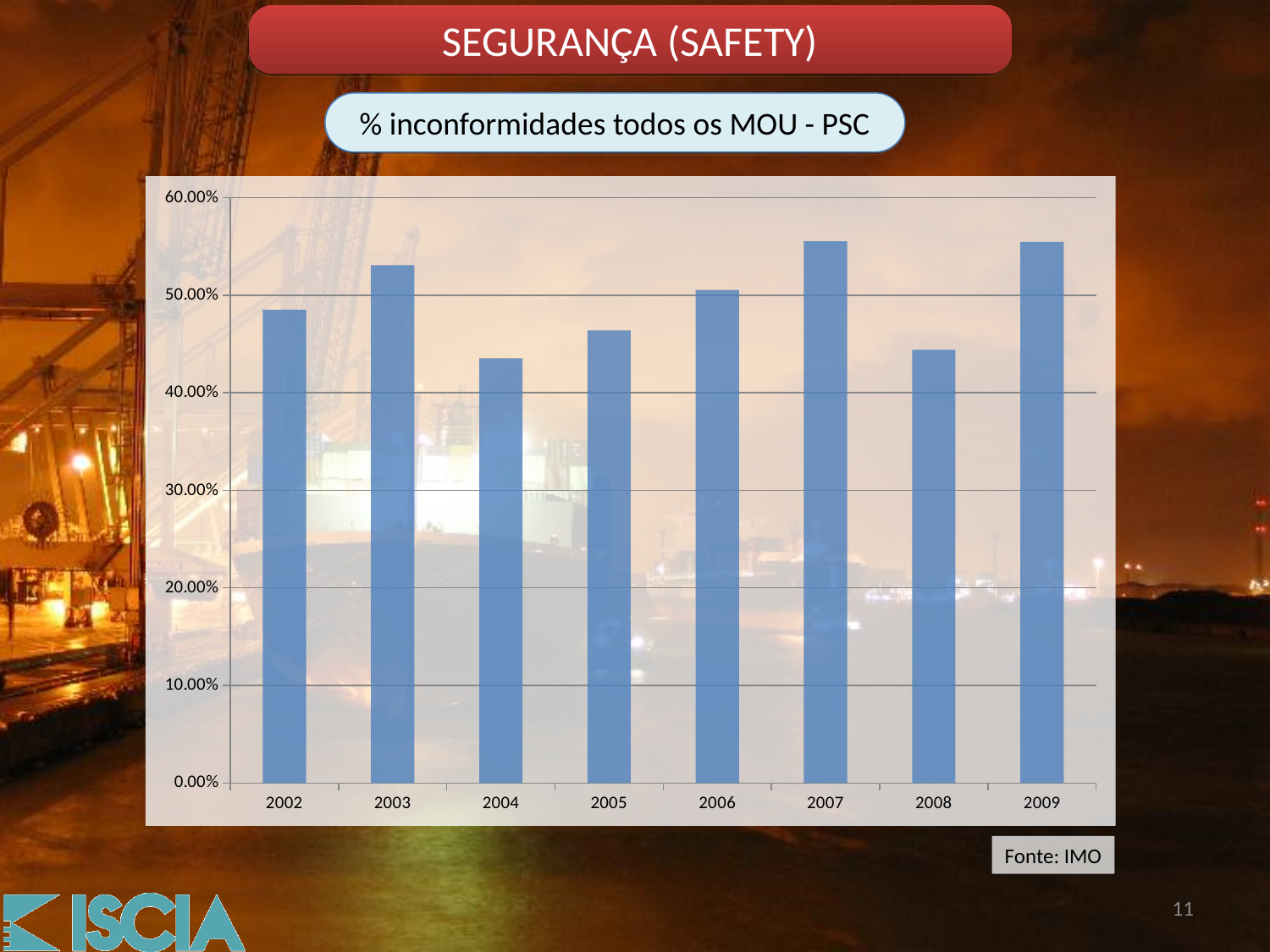
Is the value for 2009 greater or less than 60.00%? less Is the value for 2002 greater or less than 50.00%? less Which year has the larger value, 2004 or 2007? 2007 Is the value for 2004 greater or less than 40.00%? greater How many years are shown on the x axis of the chart? 8 Which year has the larger value, 2005 or 2006? 2006 What kind of chart is shown on the slide? bar chart Which year has the larger value, 2002 or 2003? 2003 What is the title of the chart? % inconformidades todos os MOU - PSC